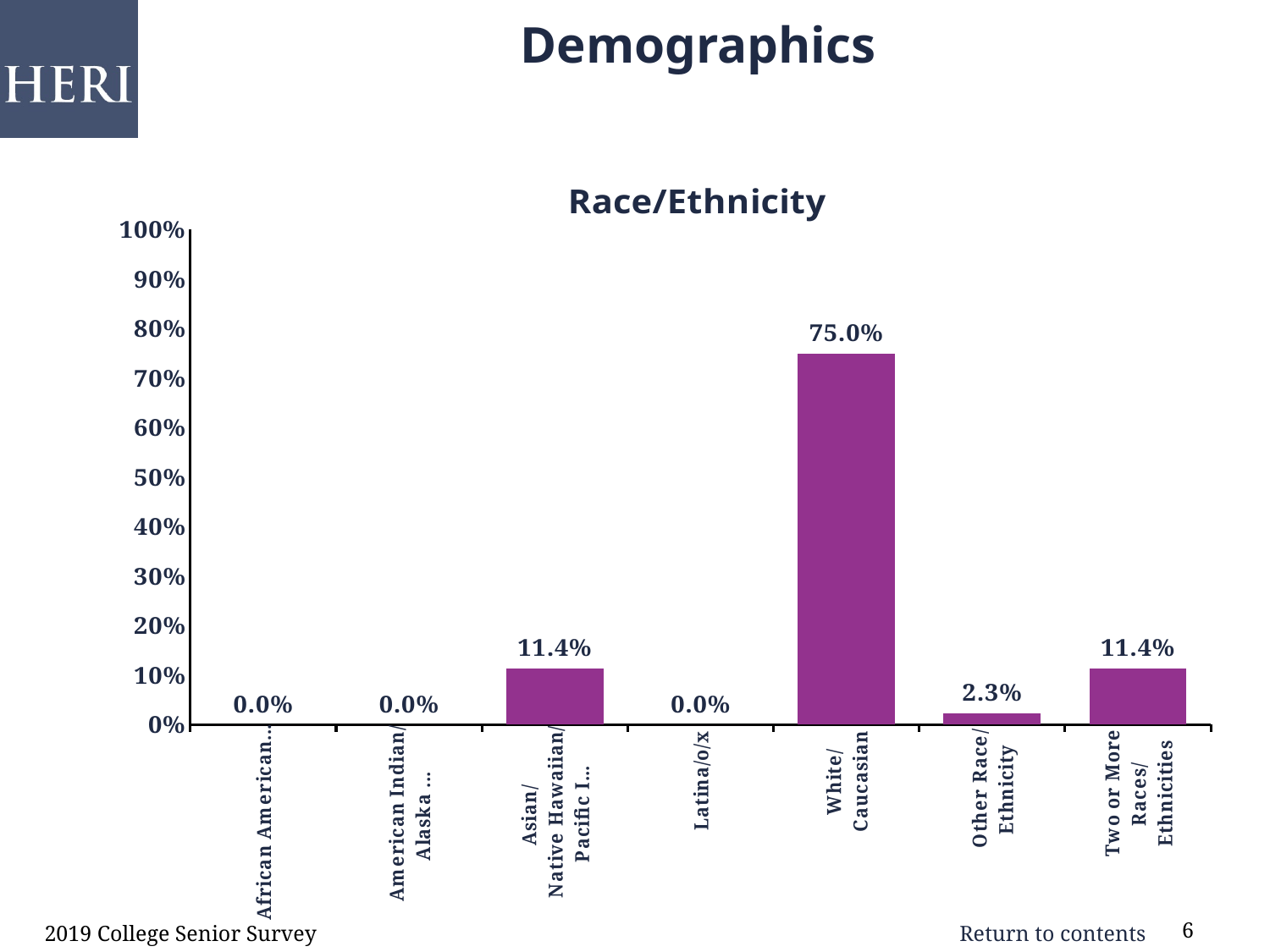
What is the value for White/Caucasian in the Race/Ethnicity chart? 75.0% What is the difference between the values for Two or More Races/Ethnicities and Other Race/Ethnicity? 9.1% What is the value for Two or More Races/Ethnicities? 11.4% What is the difference between the values for White/Caucasian and Two or More Races/Ethnicities? 63.6% What is the value for Latina/o/x? 0.0% Which is larger, the value for Other Race/Ethnicity or the value for Two or More Races/Ethnicities? Two or More Races/Ethnicities What is the title of the chart? Race/Ethnicity What is the value for Other Race/Ethnicity? 2.3% Which category has the highest value? White/Caucasian How many categories are shown on the x axis? 7 What kind of chart is shown on the slide? bar chart Is the value for White/Caucasian greater or less than 70%? greater